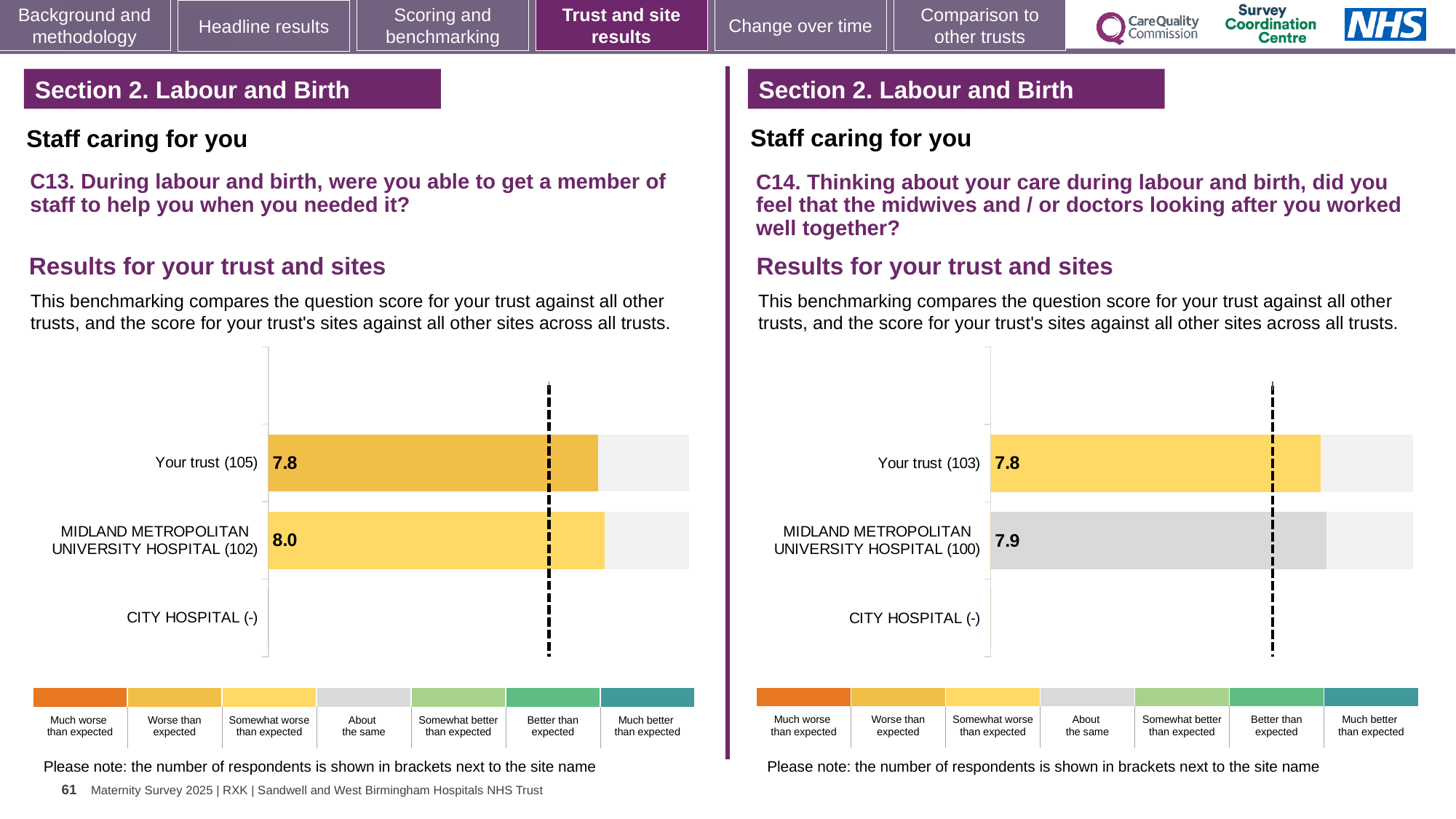
In the C14 chart on the right, which has the higher score: Your trust (103) or MIDLAND METROPOLITAN UNIVERSITY HOSPITAL (100)? MIDLAND METROPOLITAN UNIVERSITY HOSPITAL (100) How many categories are listed on the y axis of the C13 chart on the left? 3 In the C13 chart on the left, which category has no score shown? CITY HOSPITAL (-) What kind of chart is the C14 chart on the right? Bar chart In the C14 chart on the right, what is the score for Your trust (103)? 7.8 In the C13 chart on the left, which has the higher score: Your trust (105) or MIDLAND METROPOLITAN UNIVERSITY HOSPITAL (102)? MIDLAND METROPOLITAN UNIVERSITY HOSPITAL (102) How many benchmark categories does the colour legend below the C14 chart on the right list? 7 In the C13 chart on the left, what is the score for MIDLAND METROPOLITAN UNIVERSITY HOSPITAL (102)? 8.0 In the C14 chart on the right, what is the score for MIDLAND METROPOLITAN UNIVERSITY HOSPITAL (100)? 7.9 In the C14 chart on the right, what is the difference between the score for MIDLAND METROPOLITAN UNIVERSITY HOSPITAL (100) and the score for Your trust (103)? 0.1 In the C13 chart on the left, what is the difference between the score for MIDLAND METROPOLITAN UNIVERSITY HOSPITAL (102) and the score for Your trust (105)? 0.2 In the C13 chart on the left, what is the score for Your trust (105)? 7.8